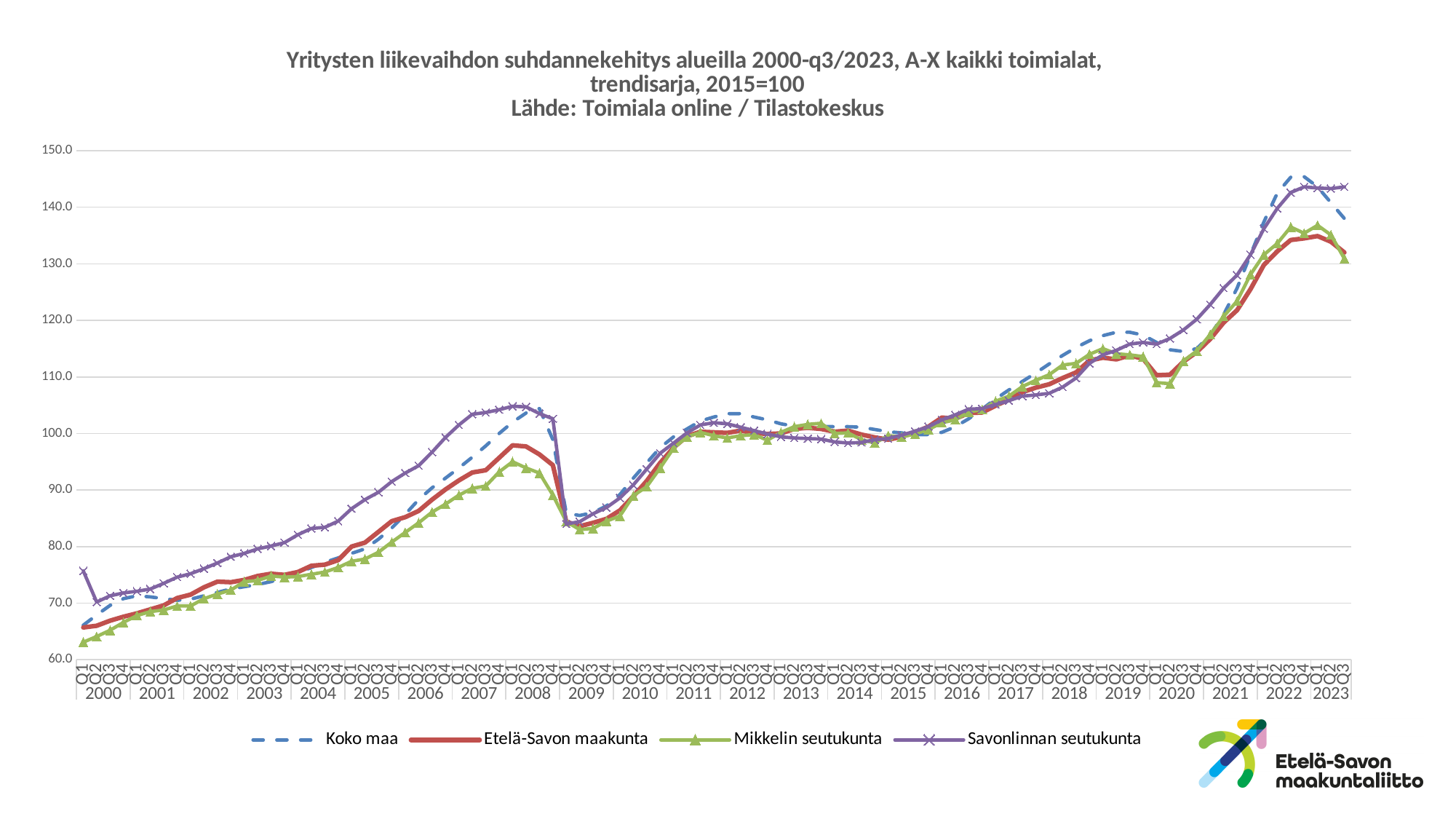
What kind of chart is shown on the slide? line chart At Q1 2008, which is higher: Savonlinnan seutukunta or Mikkelin seutukunta? Savonlinnan seutukunta Is the value for Savonlinnan seutukunta at Q3 2023 greater or less than 140? greater Which series has the highest value at Q3 2023? Savonlinnan seutukunta Is the value for Mikkelin seutukunta at Q1 2000 greater or less than 70? less Which series has the lowest value at Q1 2000? Mikkelin seutukunta Is the value for Etelä-Savon maakunta at Q1 2020 greater or less than 120? less Which series are listed in the legend? Koko maa, Etelä-Savon maakunta, Mikkelin seutukunta, Savonlinnan seutukunta Do the values for Koko maa rise or fall between Q1 2008 and Q1 2009? fall According to the chart title, which year is the index base year (=100)? 2015 How many series does the legend list? 4